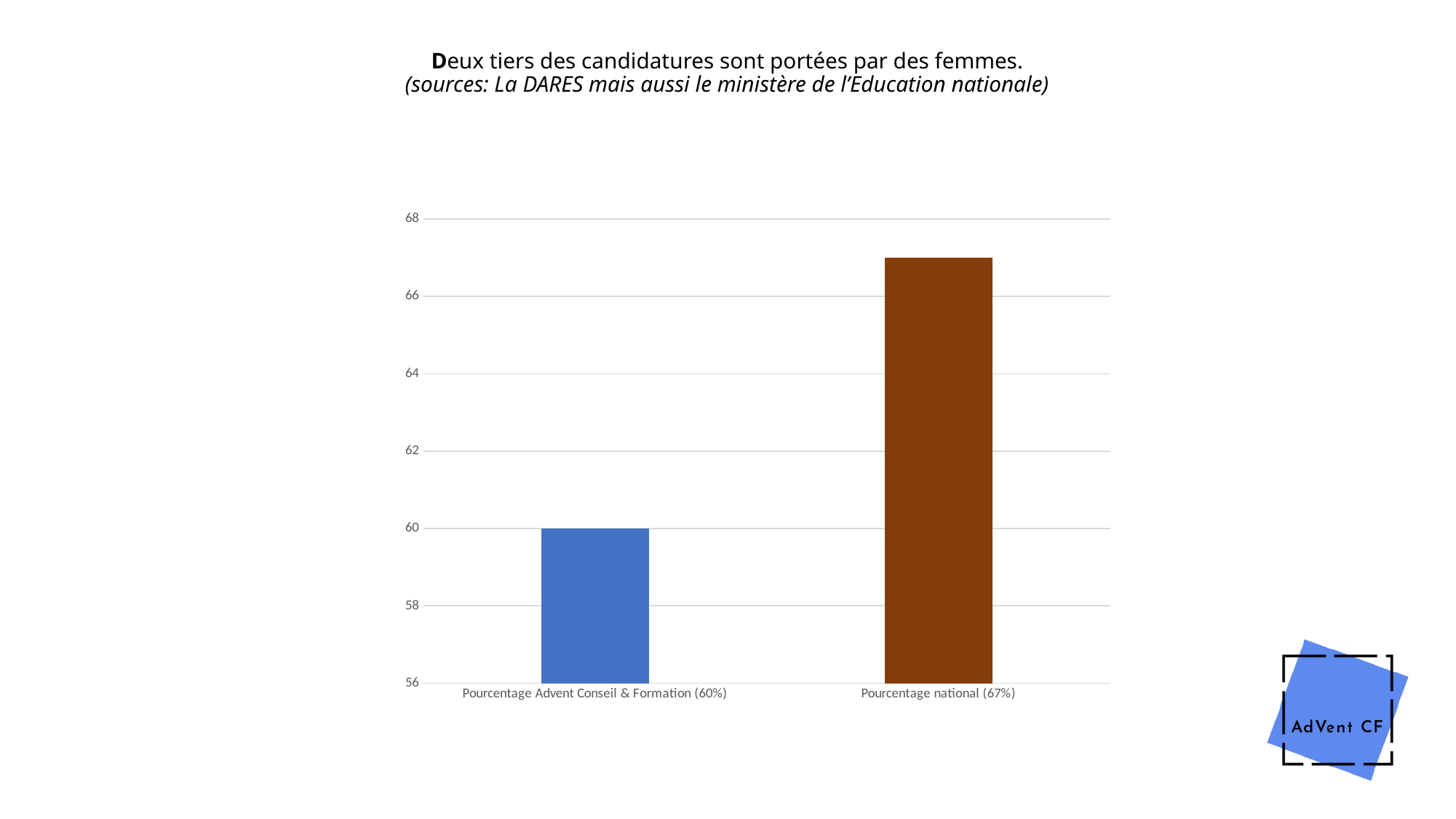
Is the value for Pourcentage national greater or less than 66? greater What colour is the bar for Pourcentage national? Brown What is the difference between Pourcentage national and Pourcentage Advent Conseil & Formation? 7% What is the value for Pourcentage national? 67% Which category has the highest value? Pourcentage national (67%) How many bars are shown in the chart? 2 What is the title of the slide above the chart? Deux tiers des candidatures sont portées par des femmes. Which category has the lowest value? Pourcentage Advent Conseil & Formation (60%) What is the value for Pourcentage Advent Conseil & Formation? 60% Which is larger, Pourcentage Advent Conseil & Formation or Pourcentage national? Pourcentage national What kind of chart is shown on the slide? Bar chart Is the value for Pourcentage Advent Conseil & Formation greater or less than 62? less